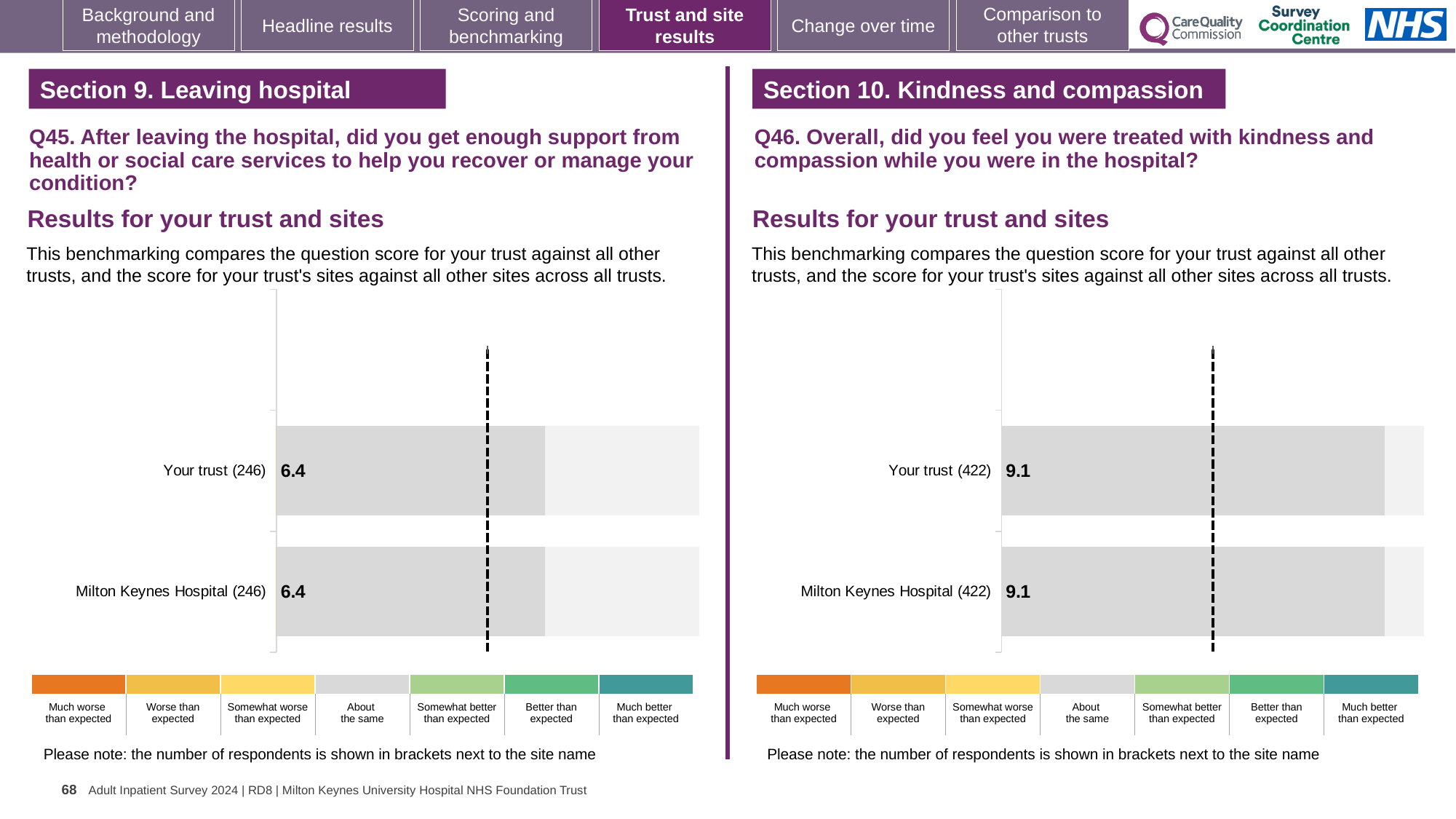
What is the difference between the Your trust score in the Q46 chart and the Your trust score in the Q45 chart? 2.7 In the Q46 chart on the right, how many respondents are shown in brackets next to Milton Keynes Hospital? 422 In the Q45 chart on the left, how many respondents are shown in brackets next to Your trust? 246 In the Q45 chart on the left, is the score for Your trust the same as the score for Milton Keynes Hospital? Yes In the Q45 chart on the left, what is the score for Milton Keynes Hospital? 6.4 In the Q46 chart on the right, what is the score for Milton Keynes Hospital? 9.1 In the Q45 chart on the left, what is the score for Your trust? 6.4 How many bars are plotted in the Q45 chart on the left? 2 In the Q46 chart on the right, what is the score for Your trust? 9.1 What kind of chart is used for the Q46 results on the right? Bar chart Which is larger: the Your trust score in the Q45 chart or the Your trust score in the Q46 chart? Q46 chart